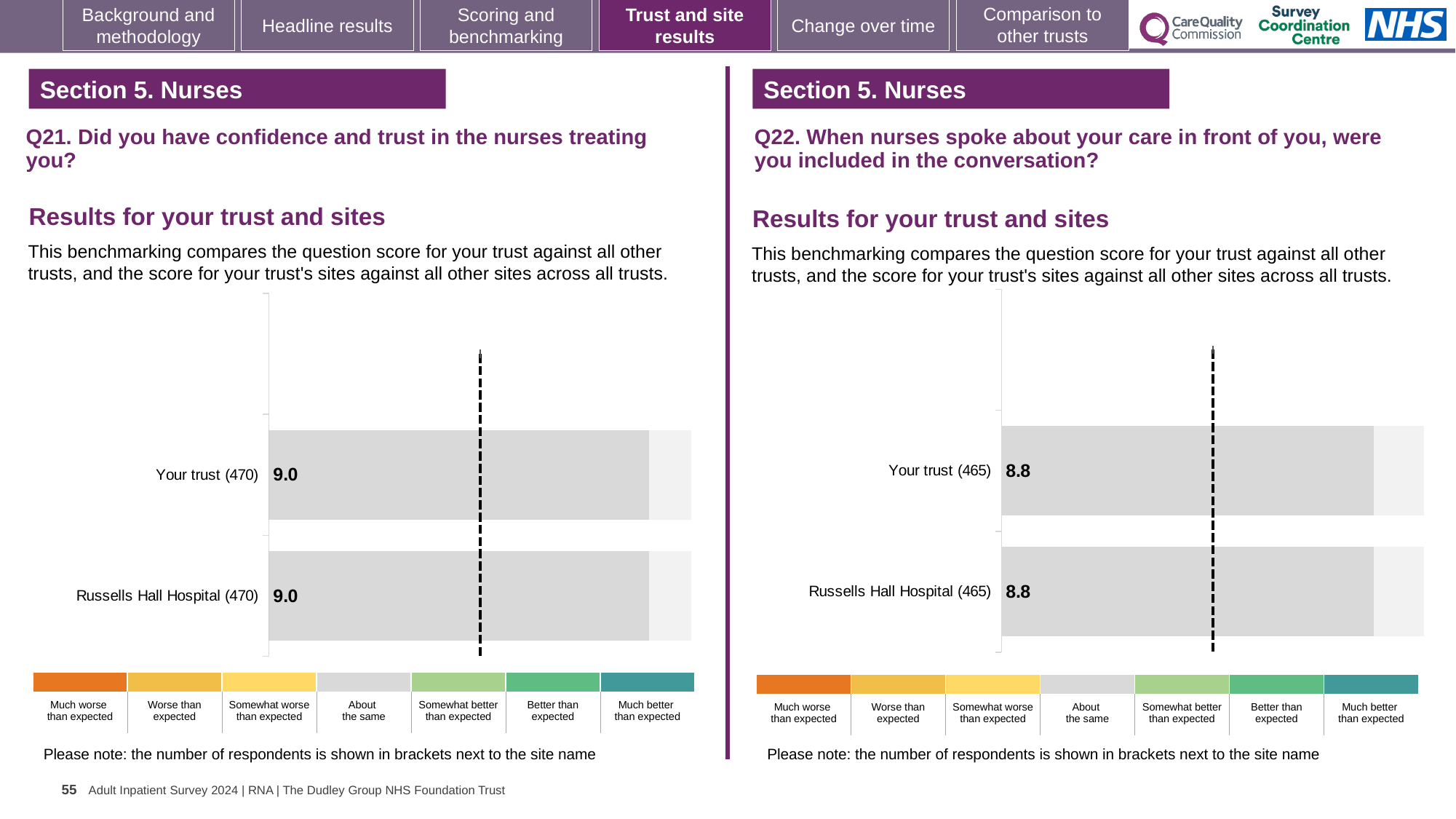
On the Q22 chart (right), what is the score for Russells Hall Hospital? 8.8 On the Q21 chart (left), how many respondents are shown in brackets for Your trust? 470 How many bars are plotted on the Q22 chart (right)? 2 On the Q22 chart (right), what is the label of the second bar from the top? Russells Hall Hospital (465) On the Q21 chart (left), what is the score for Your trust? 9.0 On the Q21 chart (left), what is the score for Russells Hall Hospital? 9.0 How many bars are plotted on the Q21 chart (left)? 2 On the Q22 chart (right), what is the score for Your trust? 8.8 What kind of chart is used for the Q22 results (right)? Bar chart What is the difference between the Your trust score on the Q21 chart (left) and the Your trust score on the Q22 chart (right)? 0.2 How many benchmark categories are shown in the colour key below the Q21 chart (left)? 7 On the Q22 chart (right), how many respondents are shown in brackets for Russells Hall Hospital? 465